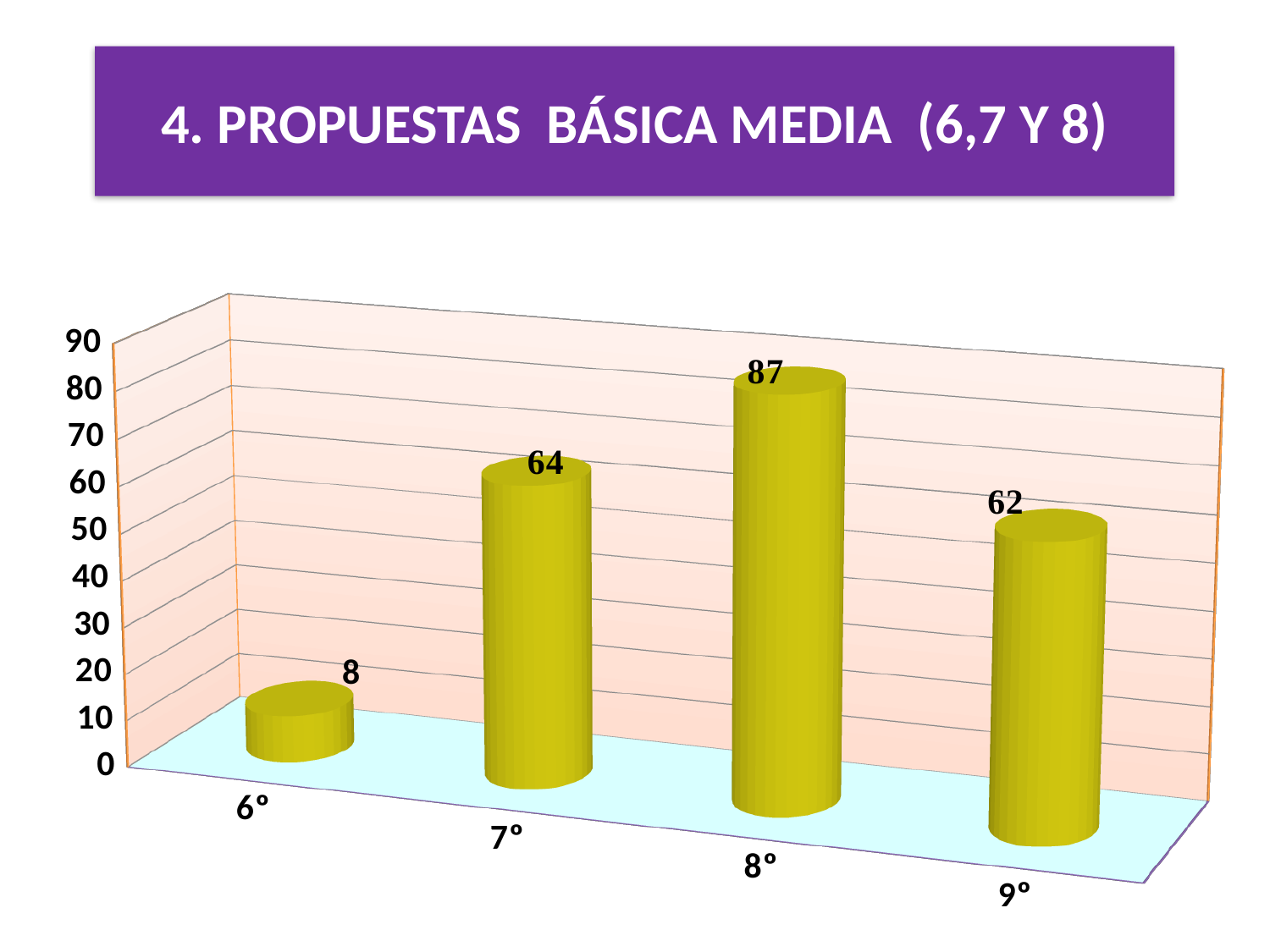
What is the difference between the values for 9° and 6°? 54 What is the value for 7°? 64 Which category has the lowest value? 6° Which is larger, the value for 7° or the value for 9°? 7° What kind of chart is shown on the slide? bar chart What is the value for 6°? 8 How many categories are shown on the x axis? 4 What is the value for 8°? 87 What is the title shown above the chart? 4. PROPUESTAS BÁSICA MEDIA (6,7 Y 8) Which category has the highest value? 8° What is the difference between the values for 8° and 7°? 23 What is the value for 9°? 62